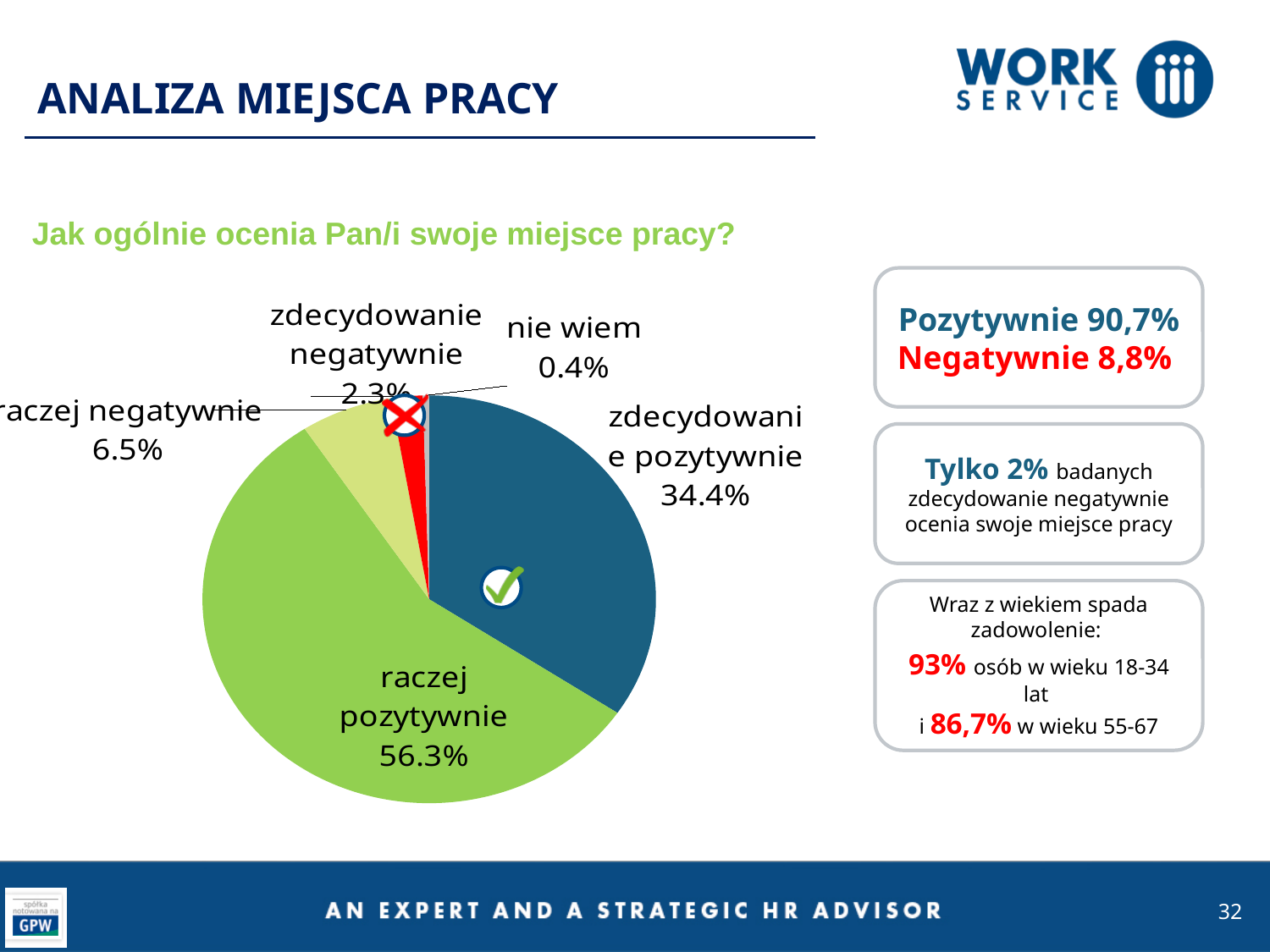
What share of the pie is labelled "zdecydowanie negatywnie"? 2.3% What share of the pie is labelled "raczej negatywnie"? 6.5% What share of the pie is labelled "nie wiem"? 0.4% Which is larger: the slice for "raczej negatywnie" or the slice for "zdecydowanie negatywnie"? raczej negatywnie How many slices does the pie chart have? 5 What kind of chart is shown on the slide? pie chart What share of the pie is labelled "zdecydowanie pozytywnie"? 34.4% What question does the pie chart answer, according to the heading above it? Jak ogólnie ocenia Pan/i swoje miejsce pracy? Which category has the smallest slice of the pie? nie wiem Which category has the largest slice of the pie? raczej pozytywnie What share of the pie is labelled "raczej pozytywnie"? 56.3% What is the difference in percentage points between the "raczej pozytywnie" and "zdecydowanie pozytywnie" slices? 21.9